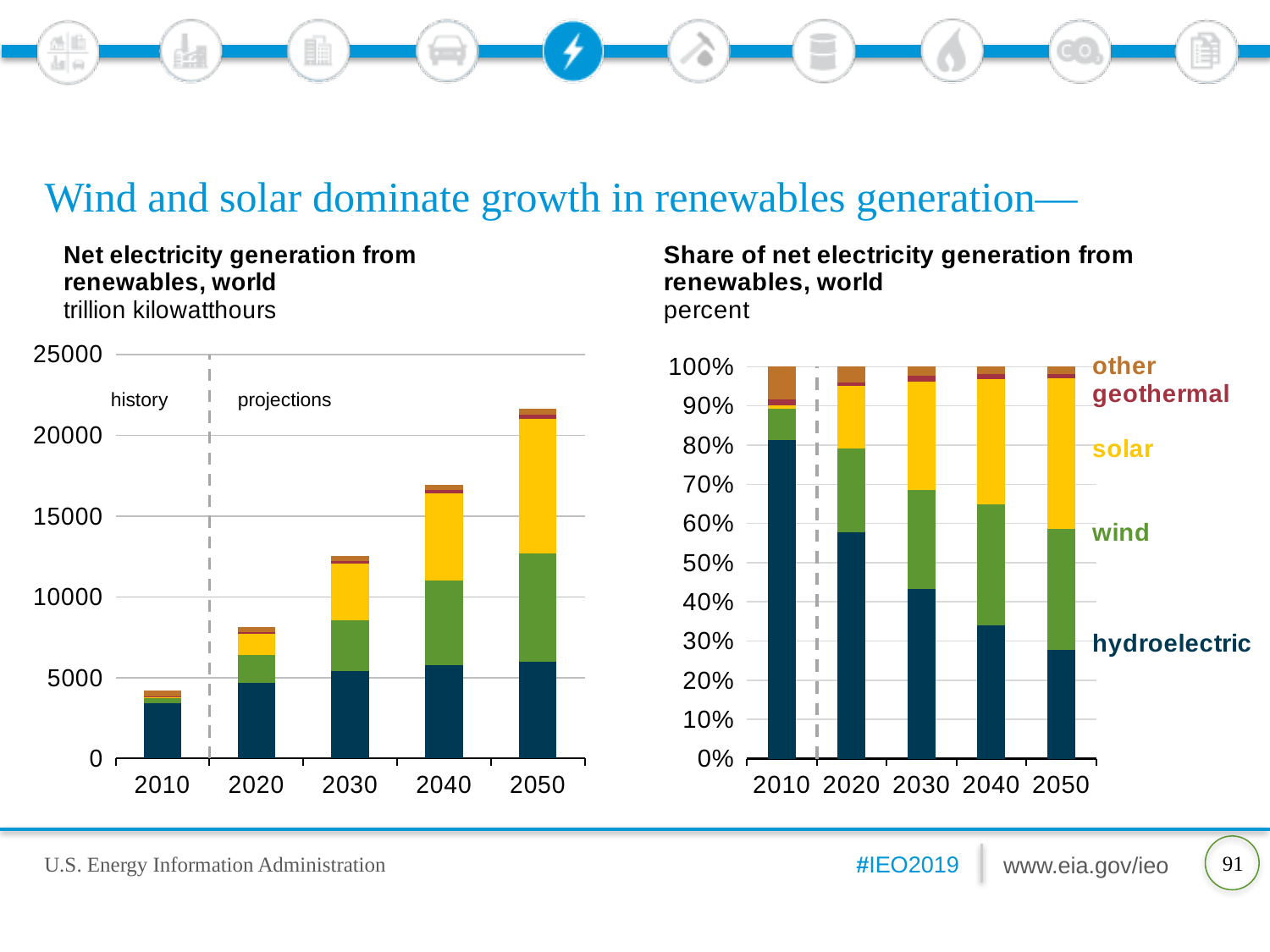
What kind of chart is the left chart, 'Net electricity generation from renewables, world'? stacked bar chart In the left chart, 'Net electricity generation from renewables, world', does total renewables generation rise or fall from 2010 to 2050? rise In the left chart, 'Net electricity generation from renewables, world', is the total bar for 2040 greater or less than 15000? greater In the left chart, 'Net electricity generation from renewables, world', which year has the shortest total bar? 2010 In the right chart, 'Share of net electricity generation from renewables, world', does the hydroelectric share rise or fall from 2010 to 2050? fall In the left chart, 'Net electricity generation from renewables, world', which year has the tallest total bar? 2050 What unit is given under the title of the left chart? trillion kilowatthours In the left chart, 'Net electricity generation from renewables, world', is the total bar for 2050 greater or less than 20000? greater How many years are shown on the x axis of the left chart, 'Net electricity generation from renewables, world'? 5 In the left chart, 'Net electricity generation from renewables, world', is the total bar for 2010 greater or less than 5000? less How many series are labelled on the right chart, 'Share of net electricity generation from renewables, world'? 5